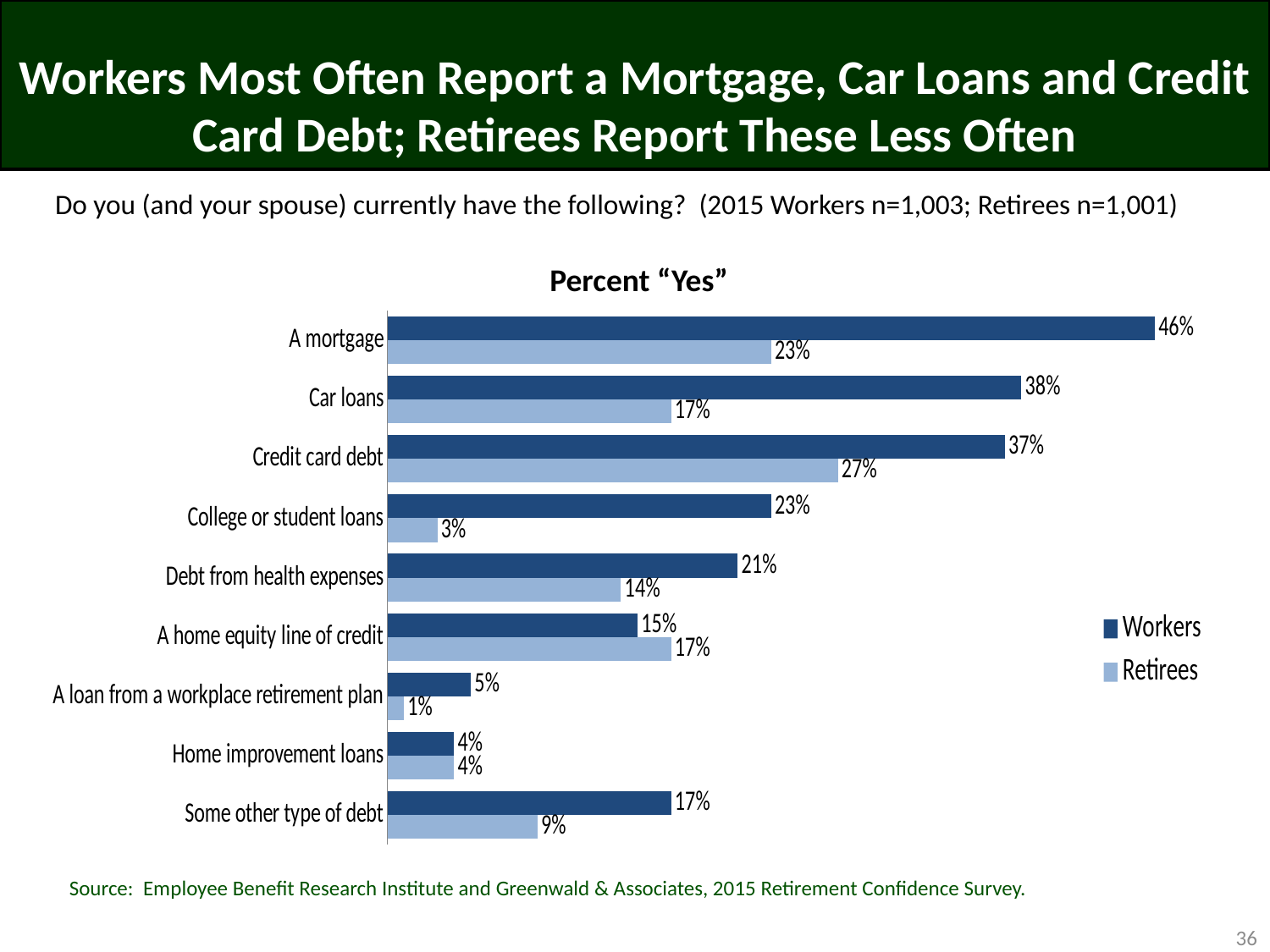
For a home equity line of credit, which group has the larger value, Workers or Retirees? Retirees Which category has the highest value for Workers? A mortgage What is the difference between the Workers and Retirees values for car loans? 21% What percentage of Retirees report having college or student loans? 3% What is the title of the chart? Percent "Yes" Which series is shown in the lighter blue colour? Retirees What percentage of Retirees report having credit card debt? 27% What kind of chart is shown on the slide? Bar chart How many debt categories are shown on the chart? 9 How many series does the legend list? 2 What percentage of Workers report having a mortgage? 46% Which category has the lowest value for Retirees? A loan from a workplace retirement plan